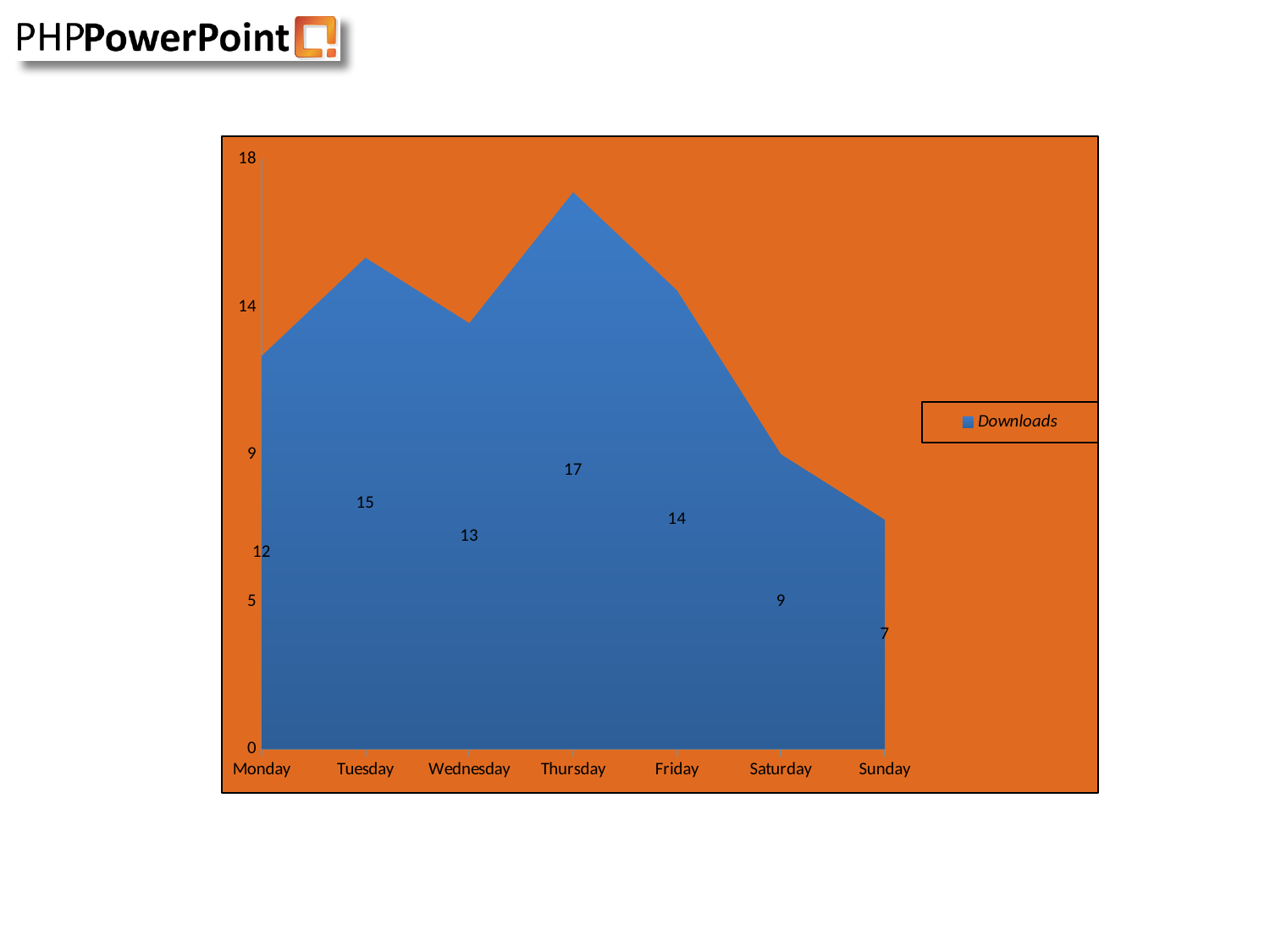
How many days are shown on the x axis? 7 Do the Downloads values rise or fall from Thursday to Sunday? fall Which day has the highest Downloads value? Thursday What is the value for Downloads on Sunday? 7 What is the value for Downloads on Monday? 12 Is the value for Saturday greater or less than 14? less How many series does the legend list? 1 Which day has the lowest Downloads value? Sunday What is the difference between the Downloads values for Thursday and Sunday? 10 What kind of chart is shown on the slide? area chart Which day has a larger Downloads value, Tuesday or Wednesday? Tuesday What is the value for Downloads on Thursday? 17